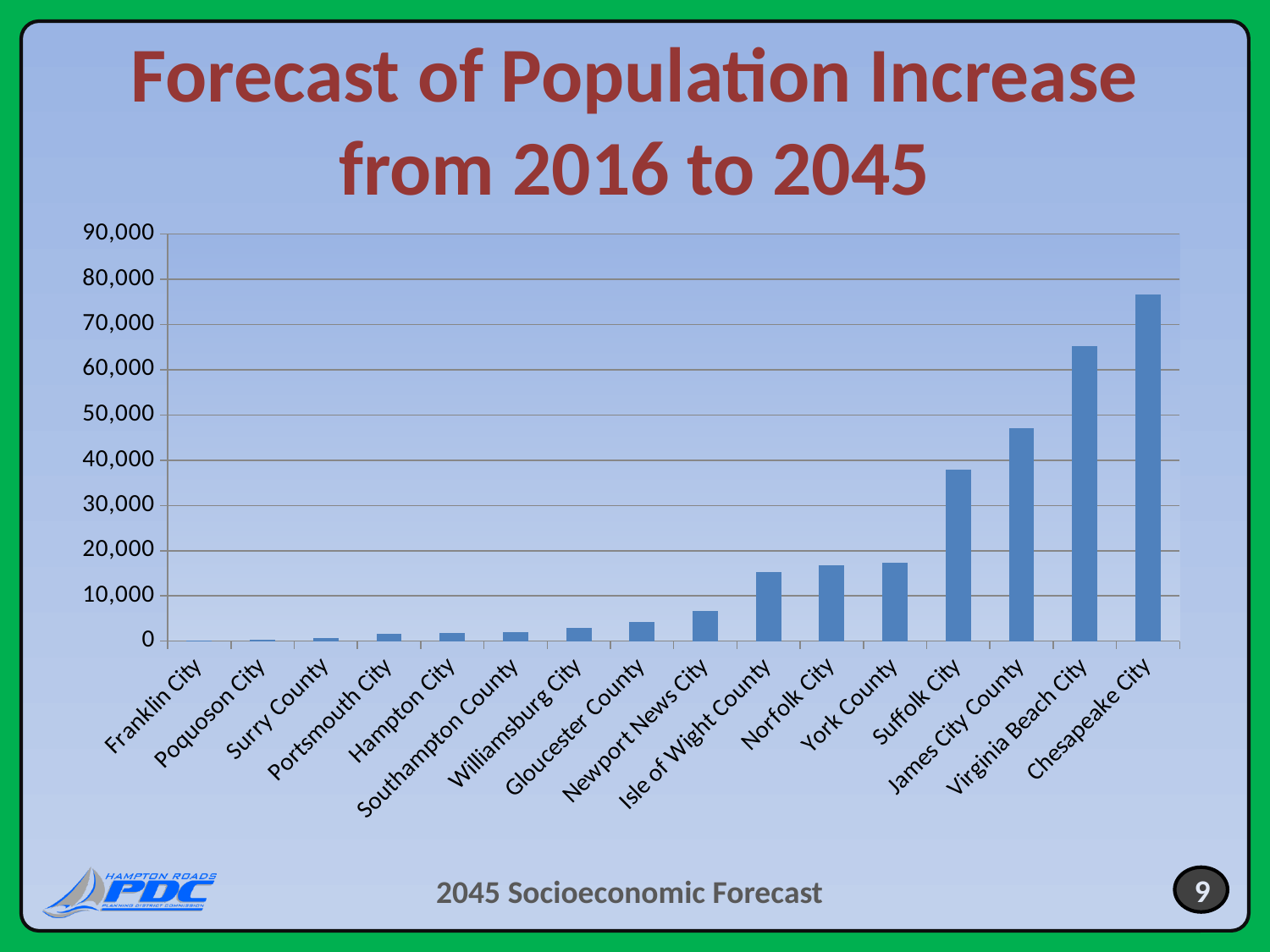
Which has a larger forecast population increase, Virginia Beach City or James City County? Virginia Beach City Is the value for Newport News City greater or less than 10,000? less Is the value for Suffolk City greater or less than 40,000? less What kind of chart is shown on the slide? bar chart Is the value for James City County greater or less than 50,000? less What is the title of the chart? Forecast of Population Increase from 2016 to 2045 Which locality has the highest forecast population increase? Chesapeake City How many localities are shown on the x axis of the chart? 16 Do the values rise or fall moving from left to right along the x axis? rise